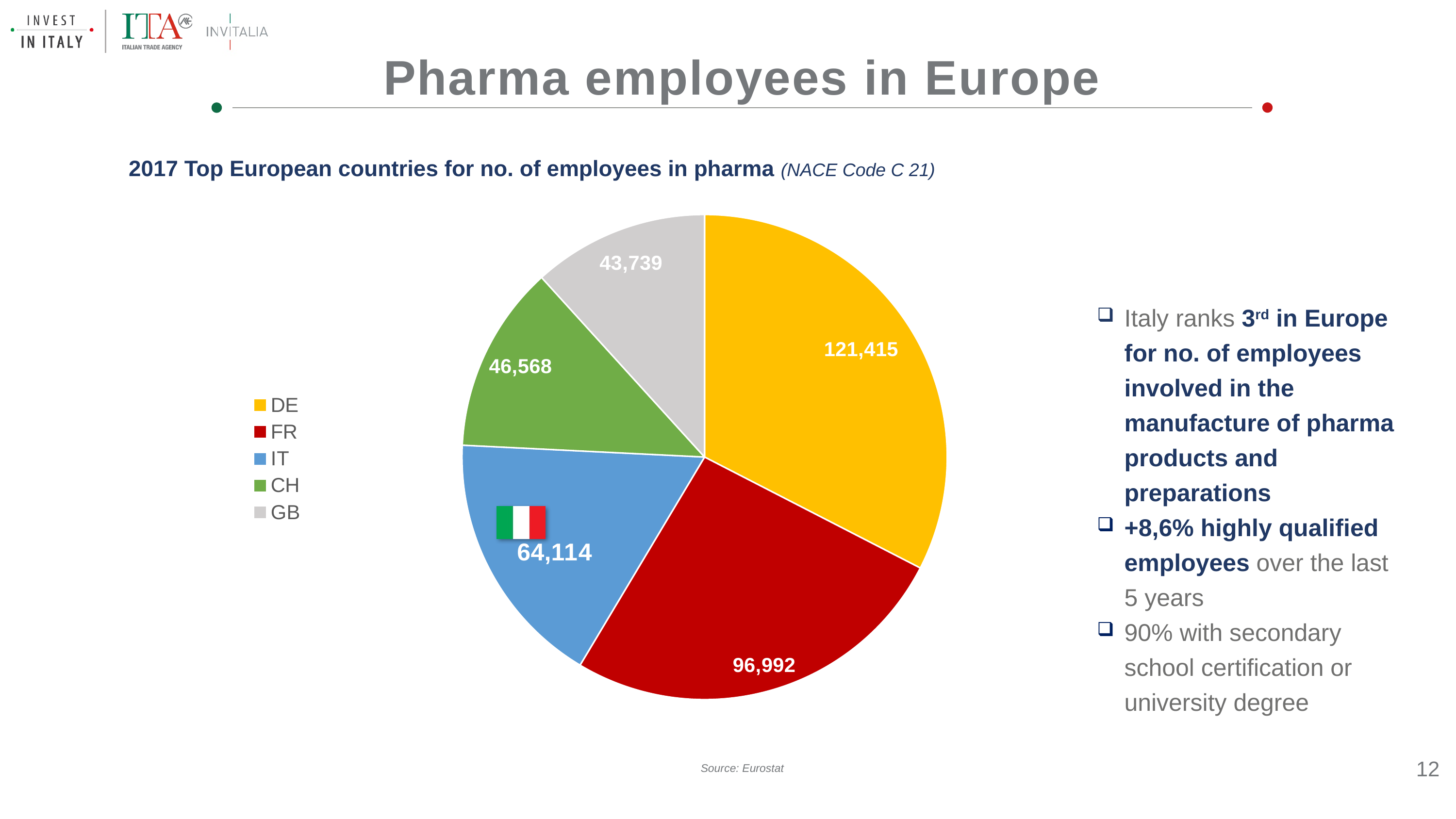
What is the difference between the values for DE and FR? 24,423 What is the difference between the values for CH and GB? 2,829 Which country has the largest slice in the pie chart? DE What is the value shown for IT in the pie chart? 64,114 How many countries are shown in the pie chart? 5 What is the value shown for DE in the pie chart? 121,415 Which has a larger value, FR or IT? FR What is the source cited for the chart? Eurostat What kind of chart is shown on the slide? Pie chart What is the value shown for GB in the pie chart? 43,739 Which country has the smallest slice in the pie chart? GB What colour is the IT slice in the pie chart? Blue